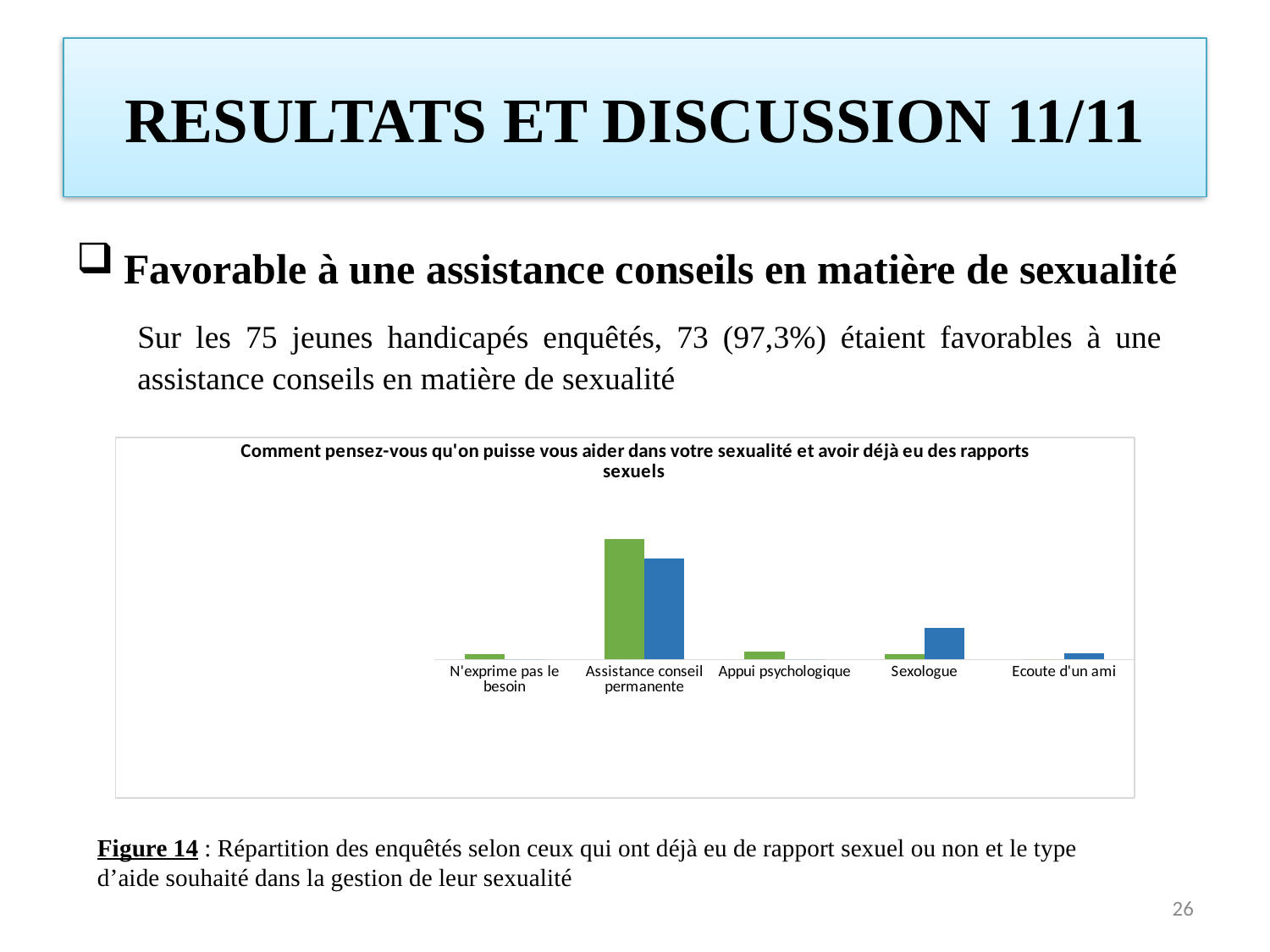
How many categories are shown on the x axis of the chart? 5 What is the title of the chart? Comment pensez-vous qu'on puisse vous aider dans votre sexualité et avoir déjà eu des rapports sexuels Which is larger: the green bar for 'Assistance conseil permanente' or the blue bar for 'Sexologue'? the green bar for Assistance conseil permanente For the category 'Sexologue', which bar is taller, the green one or the blue one? the blue one What kind of chart is shown on the slide? bar chart Which is larger: the blue bar for 'Sexologue' or the green bar for 'Appui psychologique'? the blue bar for Sexologue Which category shows only a blue bar and no green bar? Ecoute d'un ami Which category has the tallest bars in the chart? Assistance conseil permanente